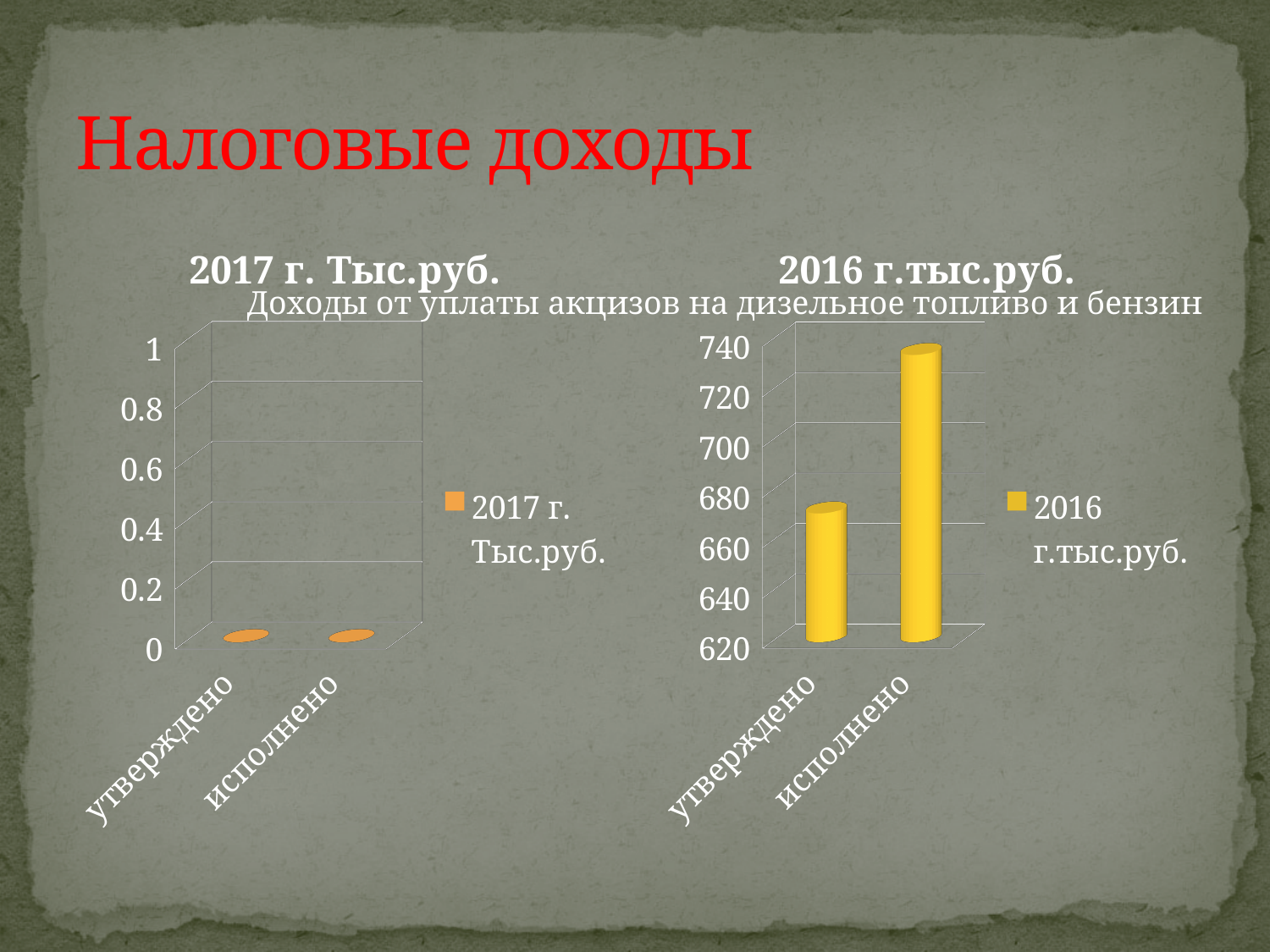
What is the legend entry of the chart titled "2016 г.тыс.руб."? 2016 г.тыс.руб. In the chart titled "2016 г.тыс.руб.", which category has the highest value? исполнено What kind of chart is the chart titled "2016 г.тыс.руб." on the right of the slide? bar chart In the chart titled "2016 г.тыс.руб.", which is larger: утверждено or исполнено? исполнено How many categories are shown on the x axis of the chart titled "2017 г. Тыс.руб."? 2 In the chart titled "2016 г.тыс.руб.", is the value for утверждено greater or less than 660? greater In the chart titled "2016 г.тыс.руб.", which category has the lowest value? утверждено What is the title of the chart on the left of the slide? 2017 г. Тыс.руб. How many categories are shown on the x axis of the chart titled "2016 г.тыс.руб."? 2 In the chart titled "2016 г.тыс.руб.", is the value for исполнено greater or less than 720? greater How many series does the legend of the chart titled "2017 г. Тыс.руб." list? 1 In the chart titled "2016 г.тыс.руб.", is the value for утверждено greater or less than 700? less